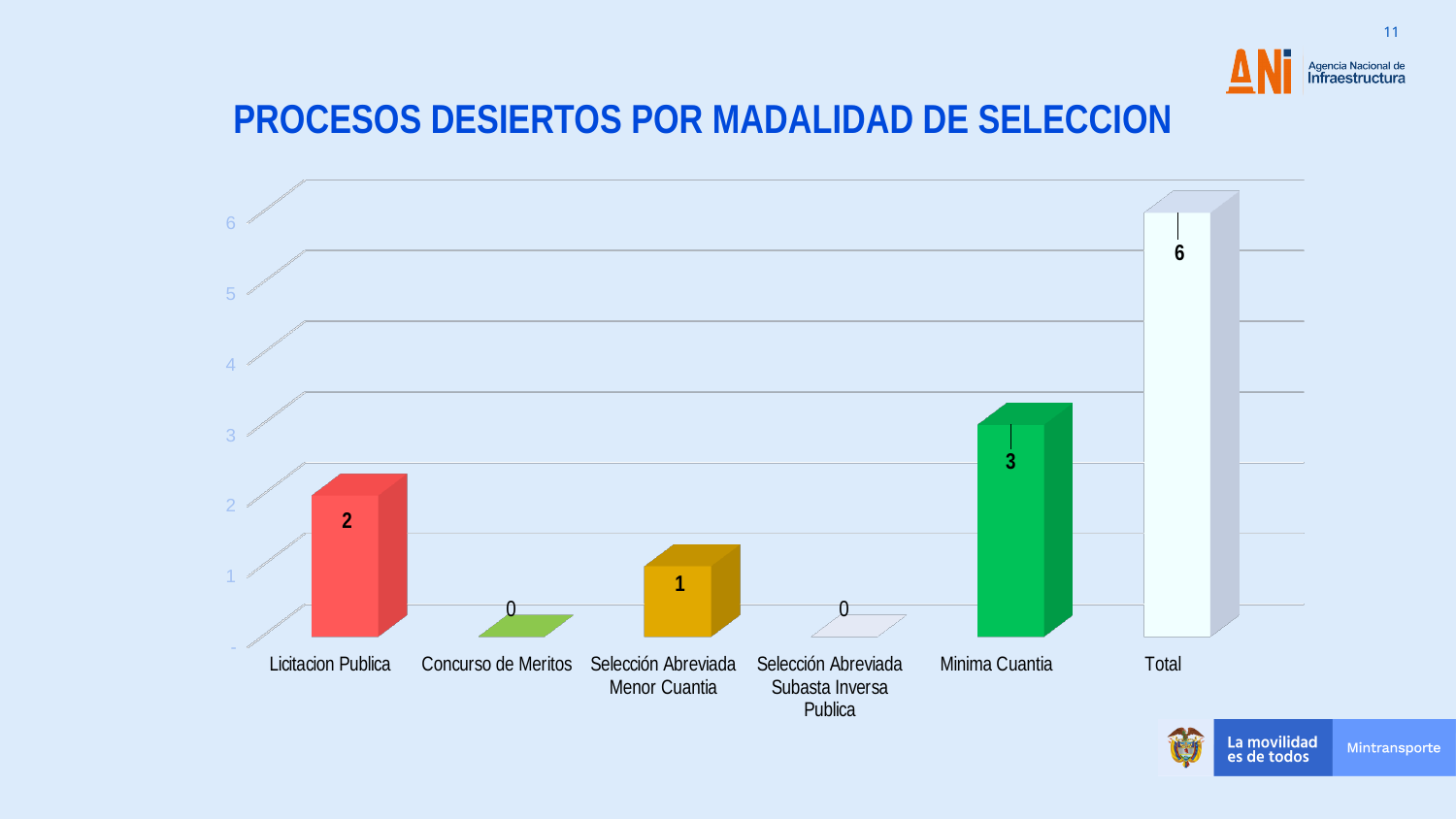
What is the value for Minima Cuantia? 3 How many categories are shown on the x axis, including Total? 6 What kind of chart is shown on the slide? Bar chart Excluding the Total bar, which category has the highest value? Minima Cuantia What is the value for Selección Abreviada Menor Cuantia? 1 What is the title of the chart? PROCESOS DESIERTOS POR MADALIDAD DE SELECCION What is the difference between the values for Minima Cuantia and Licitacion Publica? 1 What is the value shown for Total? 6 How many categories have a value of 0? 2 What is the value for Concurso de Meritos? 0 Which is larger, the value for Licitacion Publica or the value for Selección Abreviada Menor Cuantia? Licitacion Publica What is the value for Licitacion Publica? 2